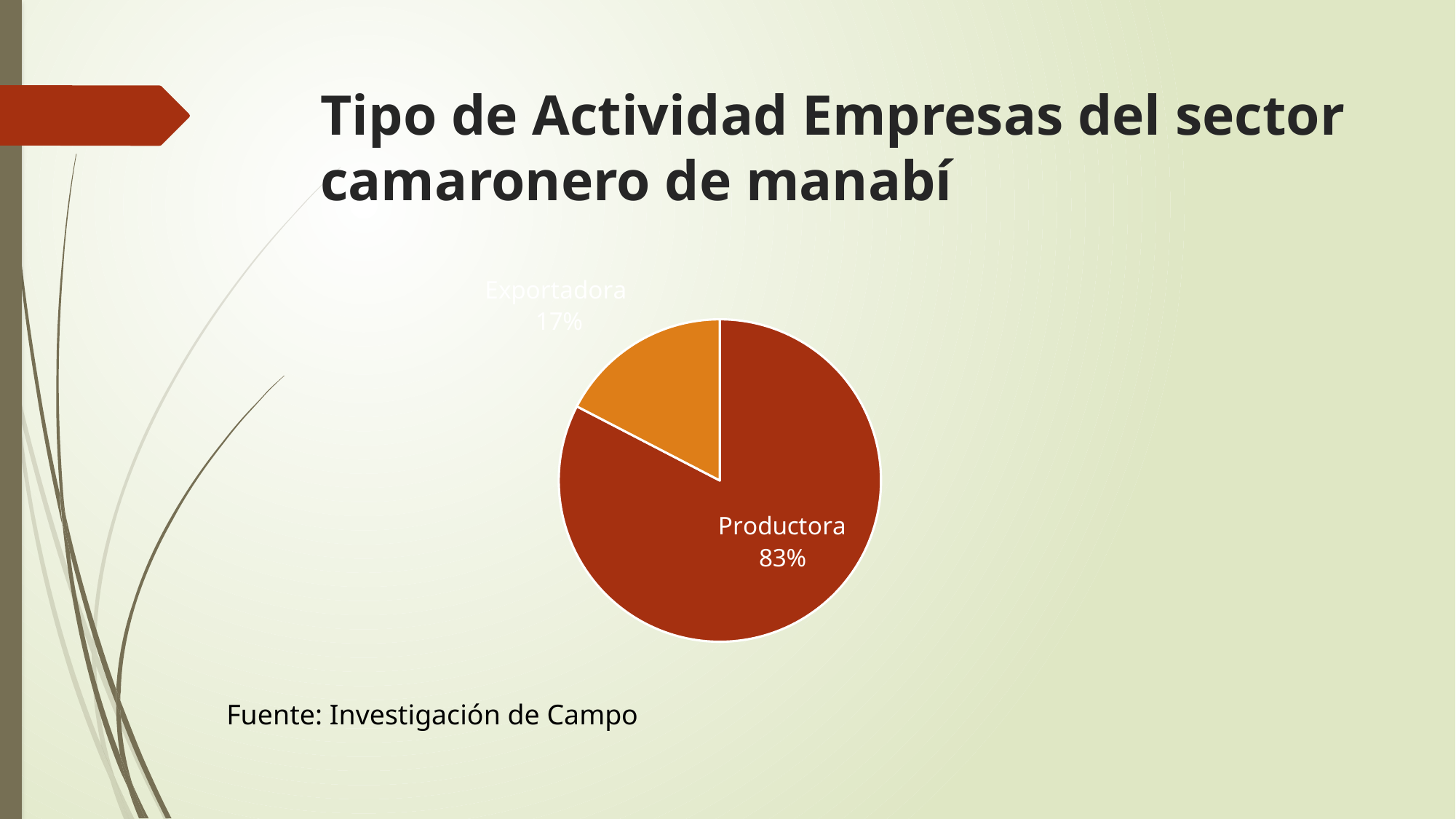
What source is cited below the pie chart? Investigación de Campo What share of the pie does Exportadora represent? 17% What is the title of the slide containing the pie chart? Tipo de Actividad Empresas del sector camaronero de manabí Which category has the largest slice of the pie? Productora How many slices does the pie chart have? 2 What is the difference in percentage points between Productora and Exportadora? 66 What share of the pie does Productora represent? 83% Which is larger, the Productora slice or the Exportadora slice? Productora What kind of chart is shown on the slide? pie chart Which category has the smallest slice of the pie? Exportadora